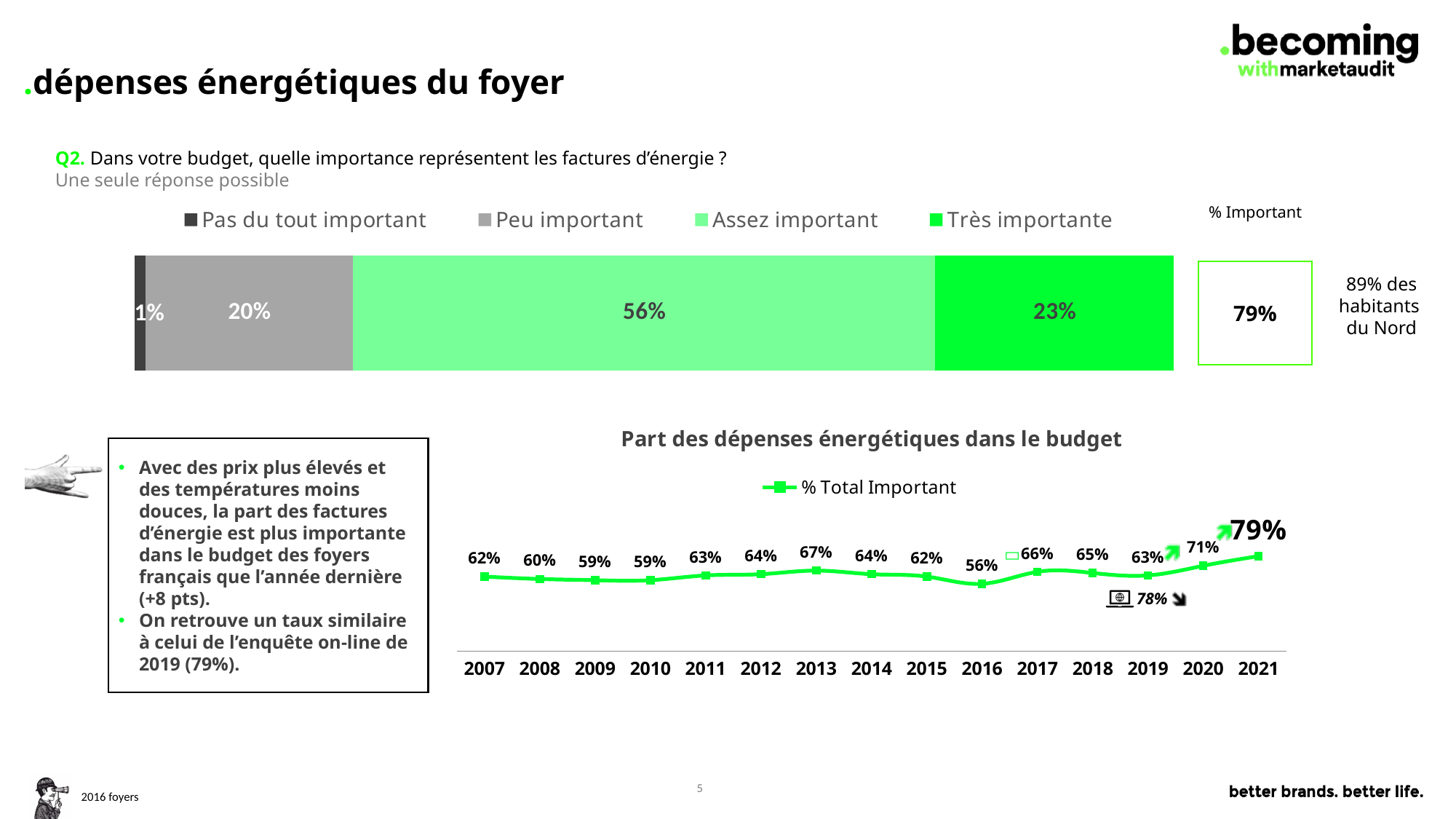
In the stacked bar chart at the top of the slide, what percentage of respondents answered "Assez important"? 56% In the stacked bar chart at the top of the slide, how many response categories does the legend list? 4 In the stacked bar chart at the top of the slide, which response category has the smallest share? Pas du tout important In the stacked bar chart at the top of the slide, what is the combined share of "Assez important" and "Très importante"? 79% In the chart "Part des dépenses énergétiques dans le budget", how many years are plotted on the x axis? 15 What kind of chart is "Part des dépenses énergétiques dans le budget"? Line chart In the stacked bar chart at the top of the slide, what percentage of respondents answered "Très importante"? 23% In the stacked bar chart at the top of the slide, what is the difference between the "Assez important" and "Peu important" shares? 36 points In the chart "Part des dépenses énergétiques dans le budget", what is the value for 2021? 79% In the chart "Part des dépenses énergétiques dans le budget", which year has the lowest value? 2016 In the chart "Part des dépenses énergétiques dans le budget", what is the difference between the 2021 and 2020 values? 8 points In the chart "Part des dépenses énergétiques dans le budget", what is the value for 2016? 56%